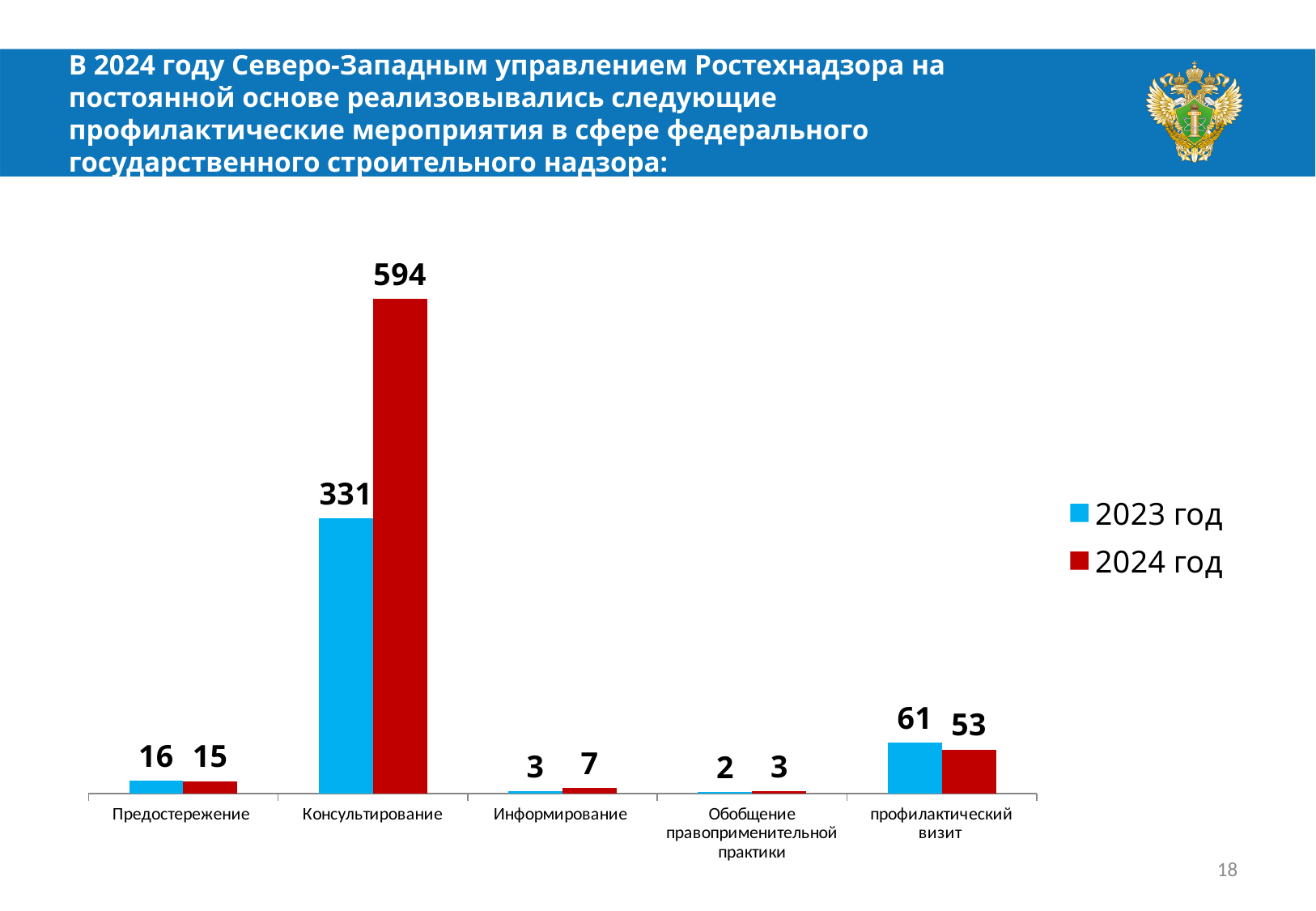
What is the value for Информирование in 2023 год? 3 What is the difference between the 2023 год and 2024 год values for профилактический визит? 8 What is the value for Предостережение in 2023 год? 16 What is the value for профилактический визит in 2024 год? 53 What kind of chart is shown on the slide? Bar chart Which category has the lowest value in 2023 год? Обобщение правоприменительной практики How many series does the legend list? 2 What is the value for Консультирование in 2024 год? 594 Which category has the highest value in 2024 год? Консультирование Which is larger for Информирование: the 2023 год value or the 2024 год value? 2024 год What is the difference between the 2024 год and 2023 год values for Консультирование? 263 How many categories are shown on the x axis? 5